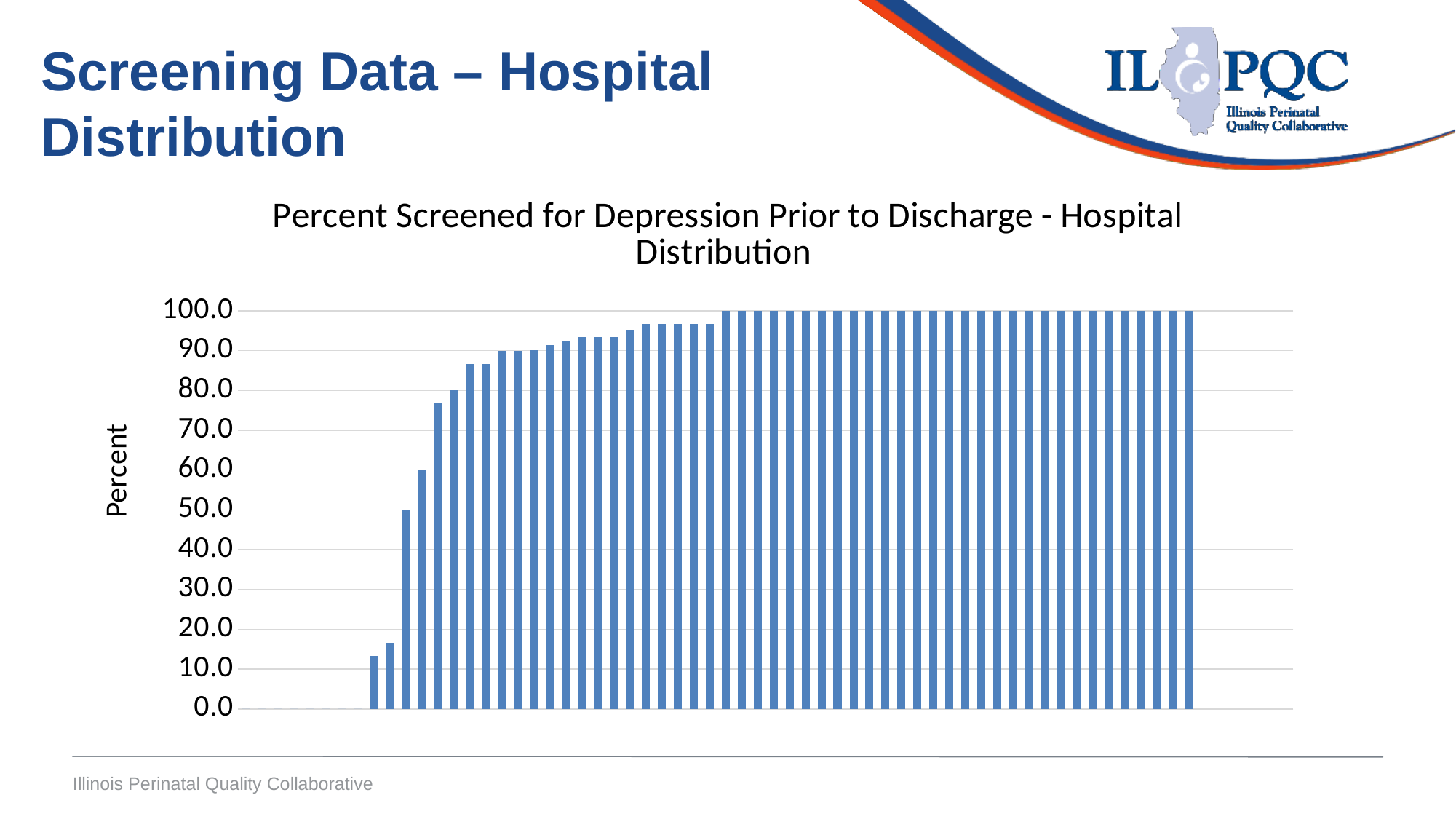
Is the value of the rightmost bar greater or less than 90? greater What is the title of the chart? Percent Screened for Depression Prior to Discharge - Hospital Distribution Do the bar values rise or fall from left to right across the chart? rise Is the value of the leftmost bar greater or less than 10? greater Is the leftmost bar or the rightmost bar taller? rightmost bar What kind of chart is shown on the slide? bar chart Is the value of the fifth bar from the left greater or less than 70? greater What is the highest tick value shown on the vertical axis? 100.0 What value do the tallest bars in the chart reach on the vertical axis? 100.0 What is the label on the vertical axis of the chart? Percent